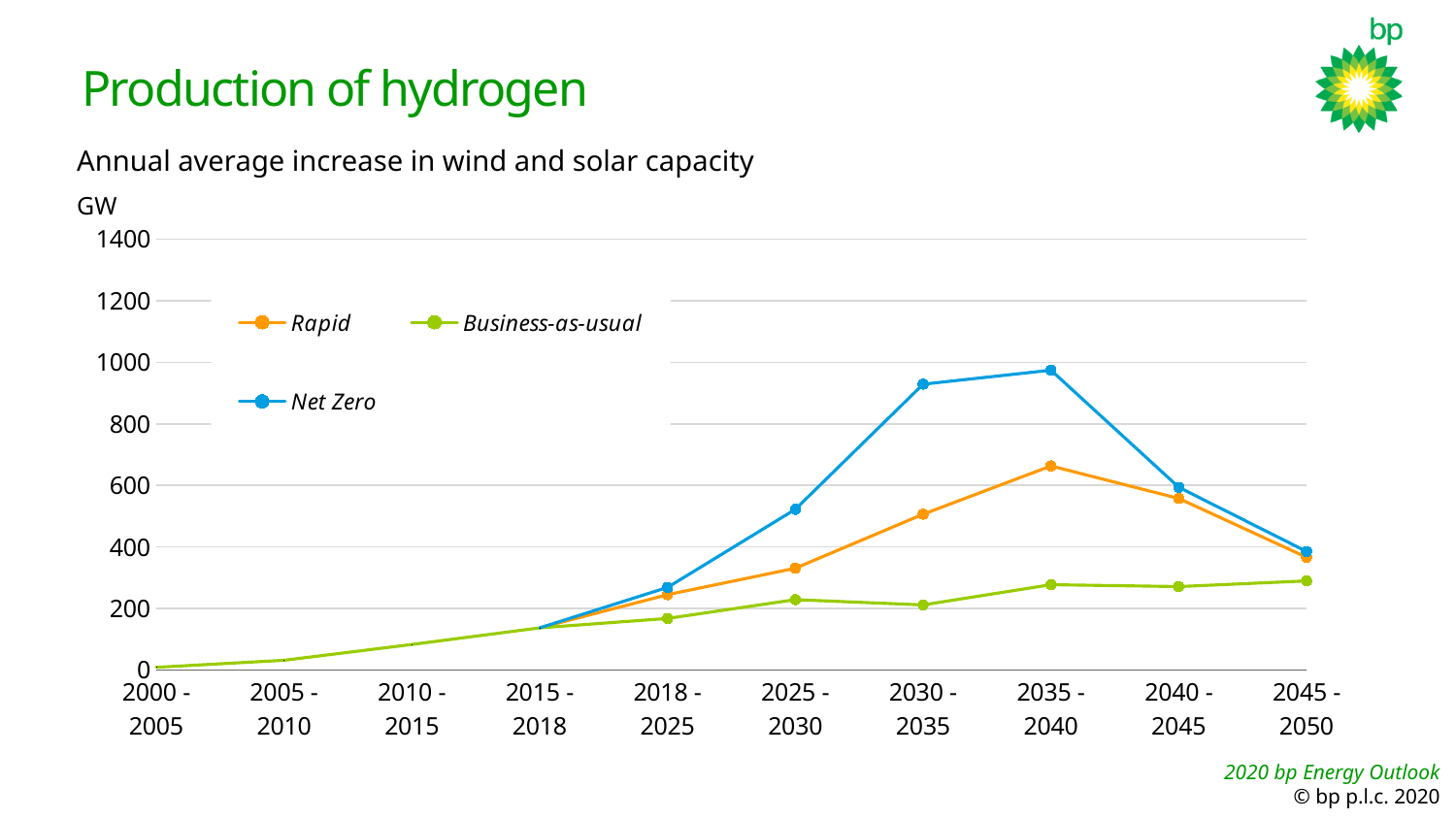
How many series does the legend list? 3 Is the value for Rapid in 2035 - 2040 greater or less than 600? greater Is the value for Business-as-usual in 2035 - 2040 greater or less than 400? less Is the value for Net Zero in 2035 - 2040 greater or less than 800? greater In which period does the Net Zero series reach its highest value? 2035 - 2040 In which period is the Business-as-usual series at its lowest value? 2000 - 2005 Which series has the highest value in the 2030 - 2035 period? Net Zero Does the Net Zero series rise or fall from 2035 - 2040 to 2045 - 2050? fall What kind of chart is shown on the slide? line chart Which is larger in 2030 - 2035, the Net Zero value or the Rapid value? Net Zero What unit is shown on the y axis of the chart? GW How many time periods are shown on the x axis? 10